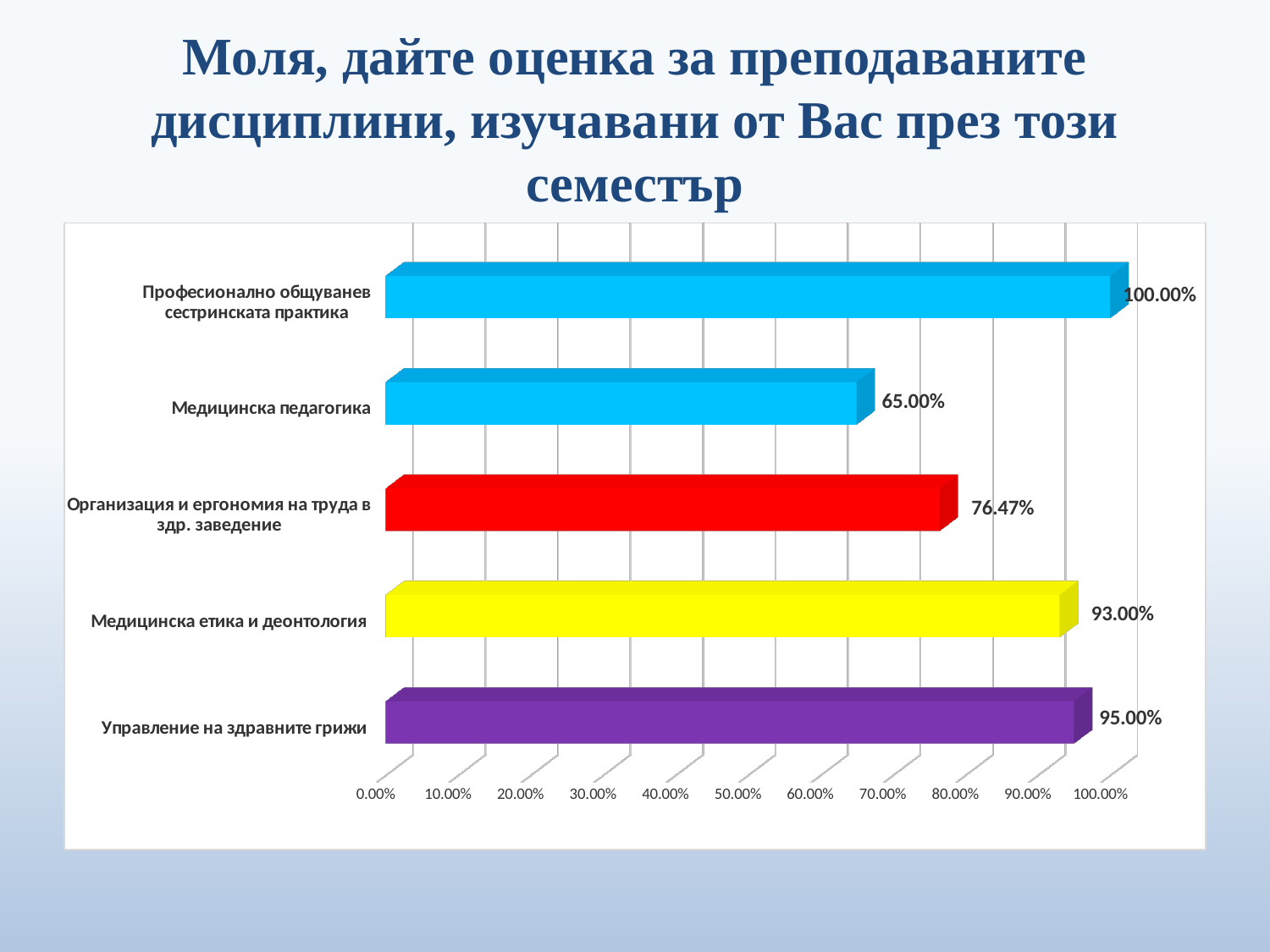
Which category has the highest value? Професионално общуванев сестринската практика What is the value for Организация и ергономия на труда в здр. заведение? 76.47% What is the value for Управление на здравните грижи? 95.00% What is the value for Медицинска педагогика? 65.00% What colour is the bar for Организация и ергономия на труда в здр. заведение? Red How many categories are shown in the chart? 5 Which category has the lowest value? Медицинска педагогика What kind of chart is shown on the slide? Bar chart What is the value for Медицинска етика и деонтология? 93.00% What is the difference between the values for Професионално общуванев сестринската практика and Медицинска педагогика? 35.00% What is the difference between the values for Управление на здравните грижи and Медицинска етика и деонтология? 2.00% Which is larger: the value for Медицинска етика и деонтология or the value for Организация и ергономия на труда в здр. заведение? Медицинска етика и деонтология